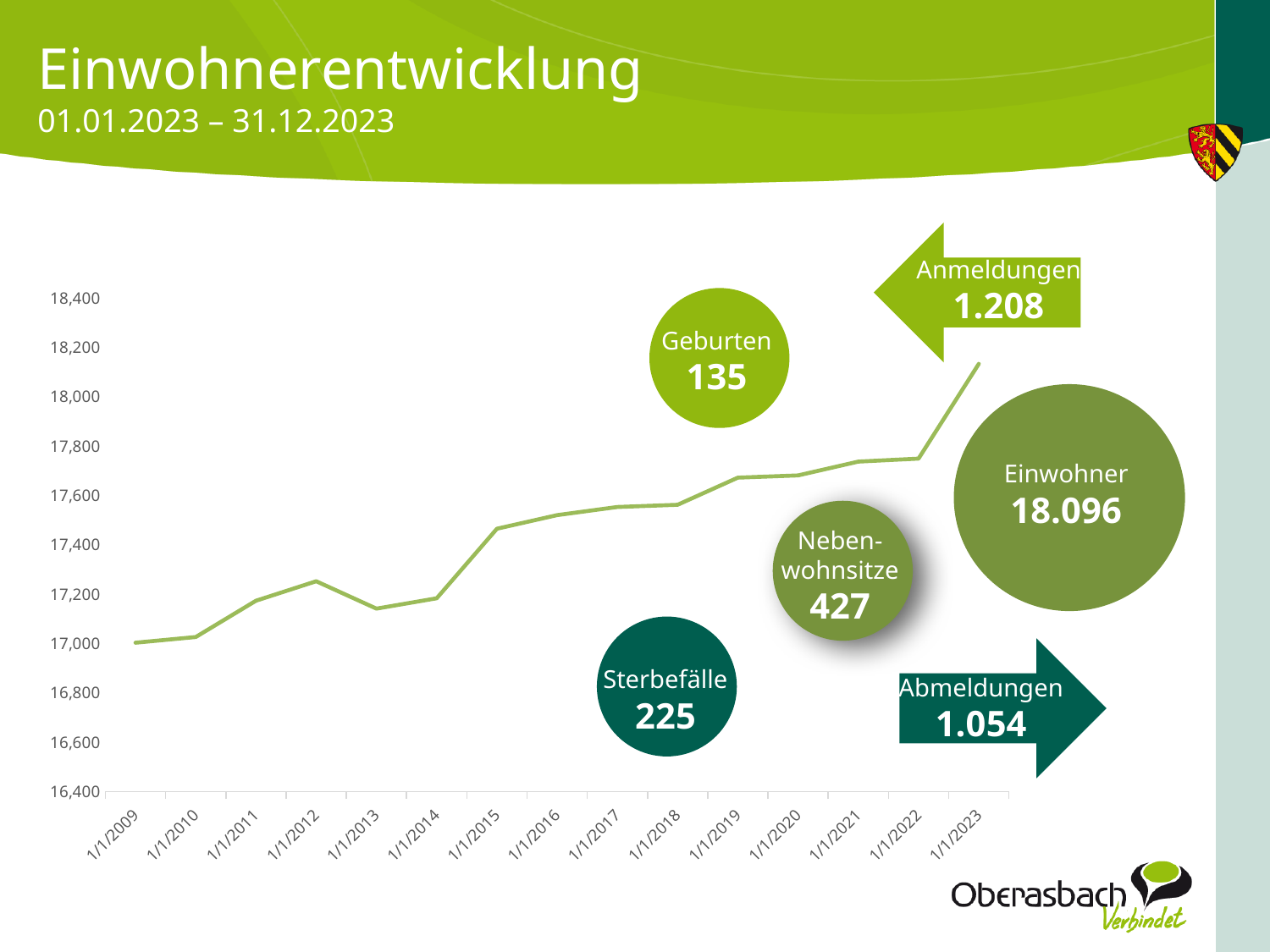
What is the first date labelled on the x axis of the line chart? 1/1/2009 Do the values in the line chart generally rise or fall from 1/1/2009 to 1/1/2023? rise Which has the larger value, 1/1/2014 or 1/1/2015? 1/1/2015 Which has the larger value, 1/1/2012 or 1/1/2013? 1/1/2012 Is the value for 1/1/2013 greater or less than 17,200? less What kind of chart is shown on the slide? line chart What is the lowest tick value shown on the y axis of the line chart? 16,400 Is the value for 1/1/2023 greater or less than 18,000? greater Is the value for 1/1/2015 greater or less than 17,400? greater How many dates are labelled along the x axis of the line chart? 15 Which date on the x axis has the highest value in the line chart? 1/1/2023